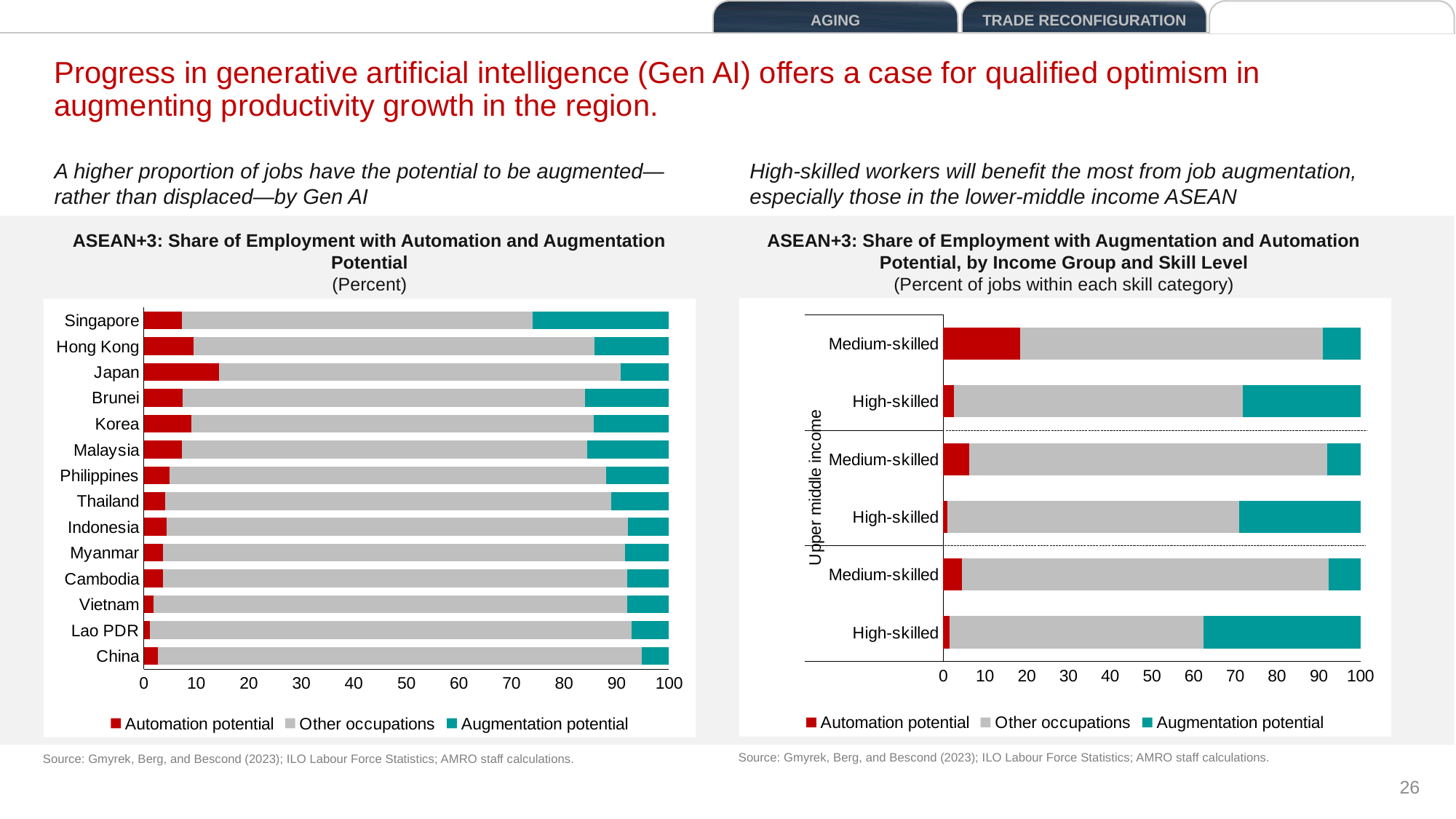
How many countries are shown in the left chart, 'ASEAN+3: Share of Employment with Automation and Augmentation Potential'? 14 What are the three legend entries of the left chart? Automation potential, Other occupations, Augmentation potential In the left chart, is the automation potential for Japan greater or less than 10? greater How many bars are plotted in the right chart, 'ASEAN+3: Share of Employment with Augmentation and Automation Potential, by Income Group and Skill Level'? 6 How many series does the legend of the left chart list? 3 What kind of chart is the left chart, 'ASEAN+3: Share of Employment with Automation and Augmentation Potential'? Stacked bar chart In the left chart, which country has the highest automation potential? Japan In the right chart, which has the larger augmentation potential, the Upper middle income High-skilled bar or the Upper middle income Medium-skilled bar? High-skilled In the left chart, is the augmentation potential for China greater or less than 10? less In the right chart, is the automation potential for the topmost Medium-skilled bar greater or less than 10? greater In the left chart, which has the larger augmentation potential, Singapore or Japan? Singapore In the left chart, which country has the highest augmentation potential? Singapore